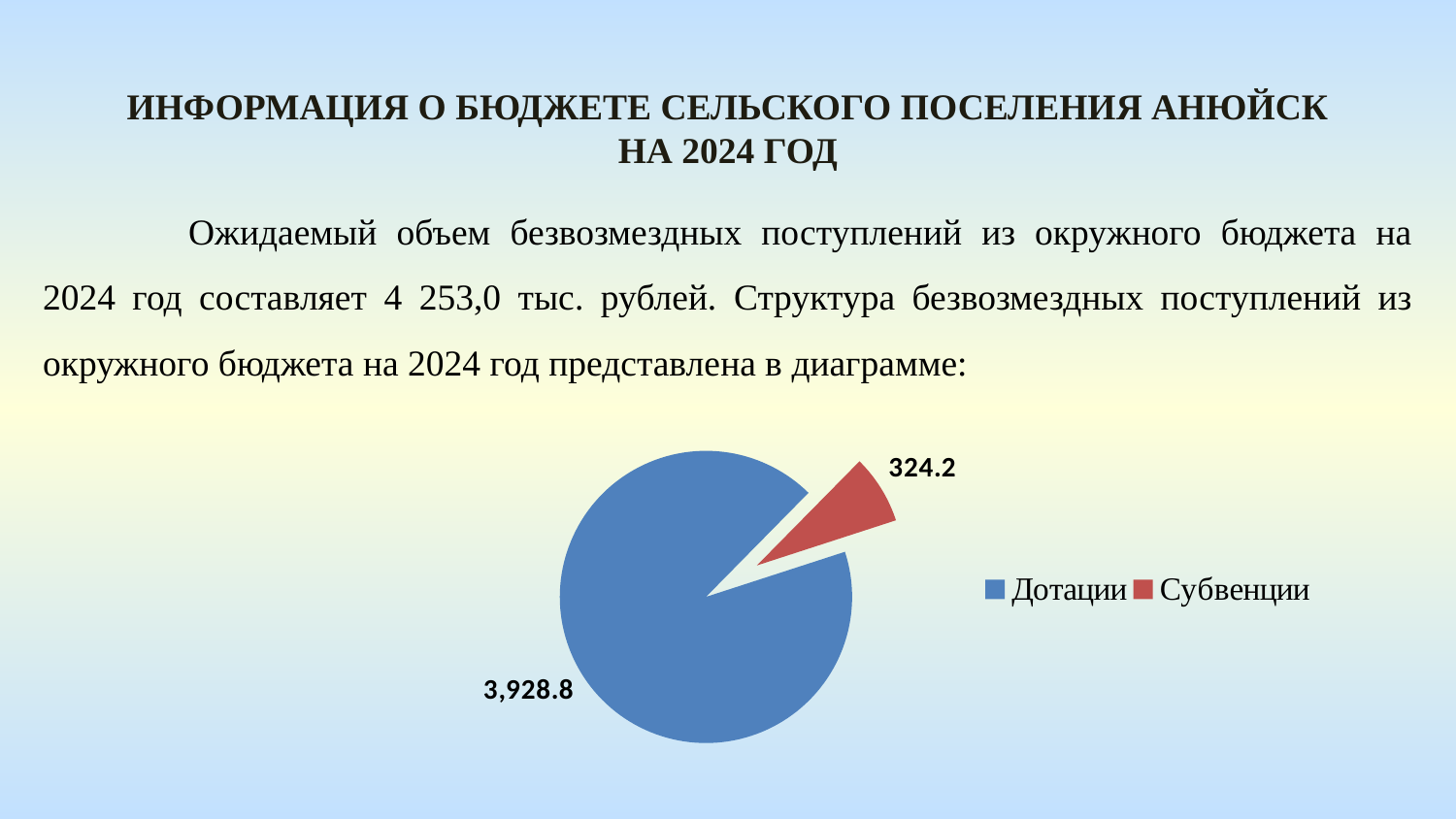
How many entries does the legend list? 2 What is the value for Дотации in the pie chart? 3,928.8 Which category has the smallest slice in the pie chart? Субвенции What kind of chart is shown on the slide? pie chart Which category has the largest slice in the pie chart? Дотации What is the total of the two slices in the pie chart? 4,253.0 What colour is the Субвенции slice in the pie chart? red What share of the pie does Субвенции represent, to the nearest whole percent? 8% Which is larger, Дотации or Субвенции? Дотации How many slices does the pie chart have? 2 What is the value for Субвенции in the pie chart? 324.2 What is the difference between the values for Дотации and Субвенции? 3,604.6